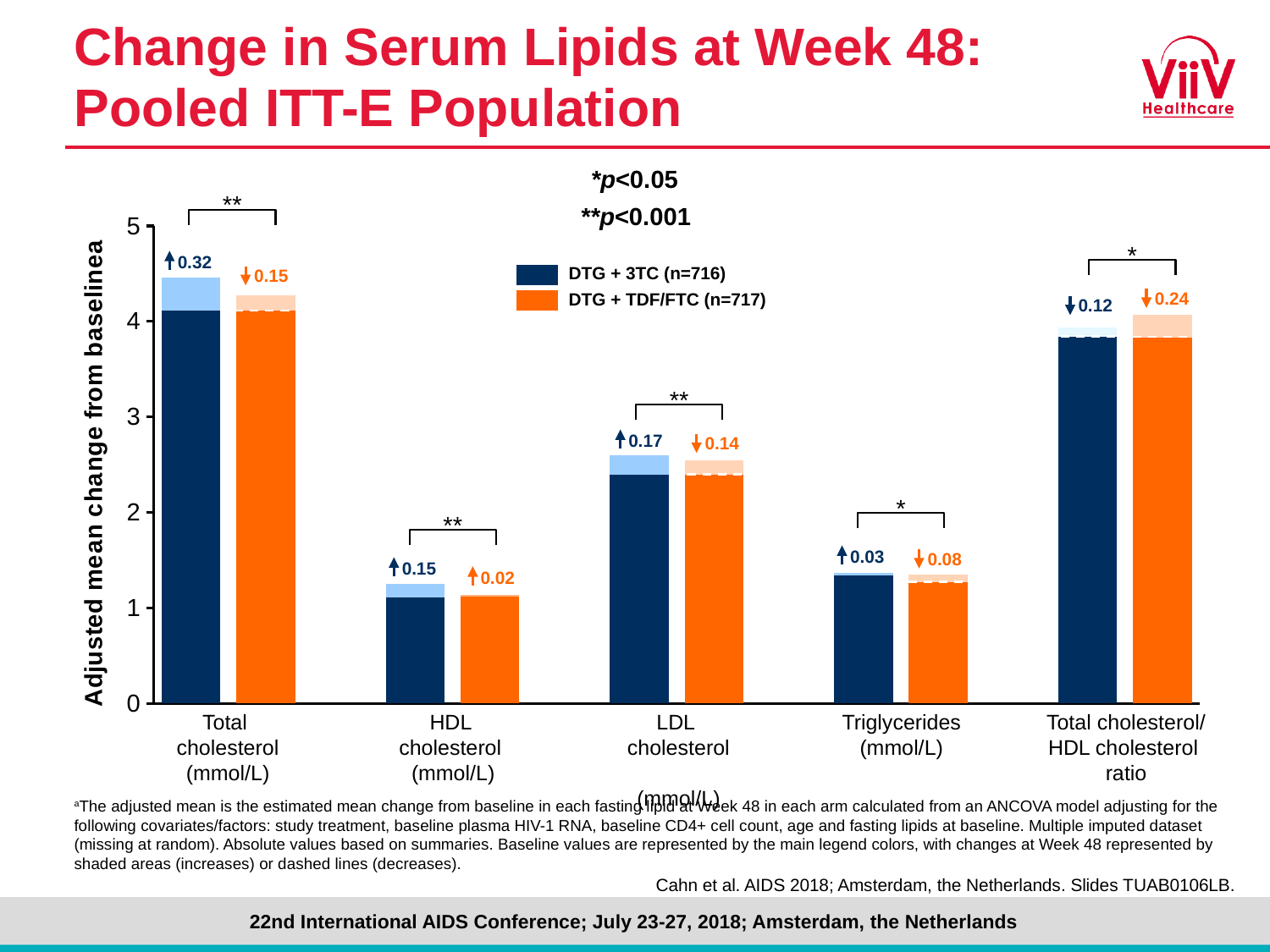
What are the two series named in the legend? DTG + 3TC (n=716) and DTG + TDF/FTC (n=717) Is the DTG + 3TC bar for LDL cholesterol greater or less than 2? greater What kind of chart is shown on the slide? bar chart What change from baseline is labelled for DTG + TDF/FTC in the HDL cholesterol category? 0.02 In the Total cholesterol category, which series has the larger labelled change from baseline, DTG + 3TC or DTG + TDF/FTC? DTG + 3TC What is the difference between the labelled changes for DTG + 3TC (0.32) and DTG + TDF/FTC (0.15) in the Total cholesterol category? 0.17 What change from baseline is labelled for DTG + TDF/FTC in the Total cholesterol/HDL cholesterol ratio category? 0.24 What change from baseline is labelled for DTG + 3TC in the Total cholesterol category? 0.32 What change from baseline is labelled for DTG + 3TC in the Triglycerides category? 0.03 How many lipid categories are shown along the x axis? 5 How many series does the legend list? 2